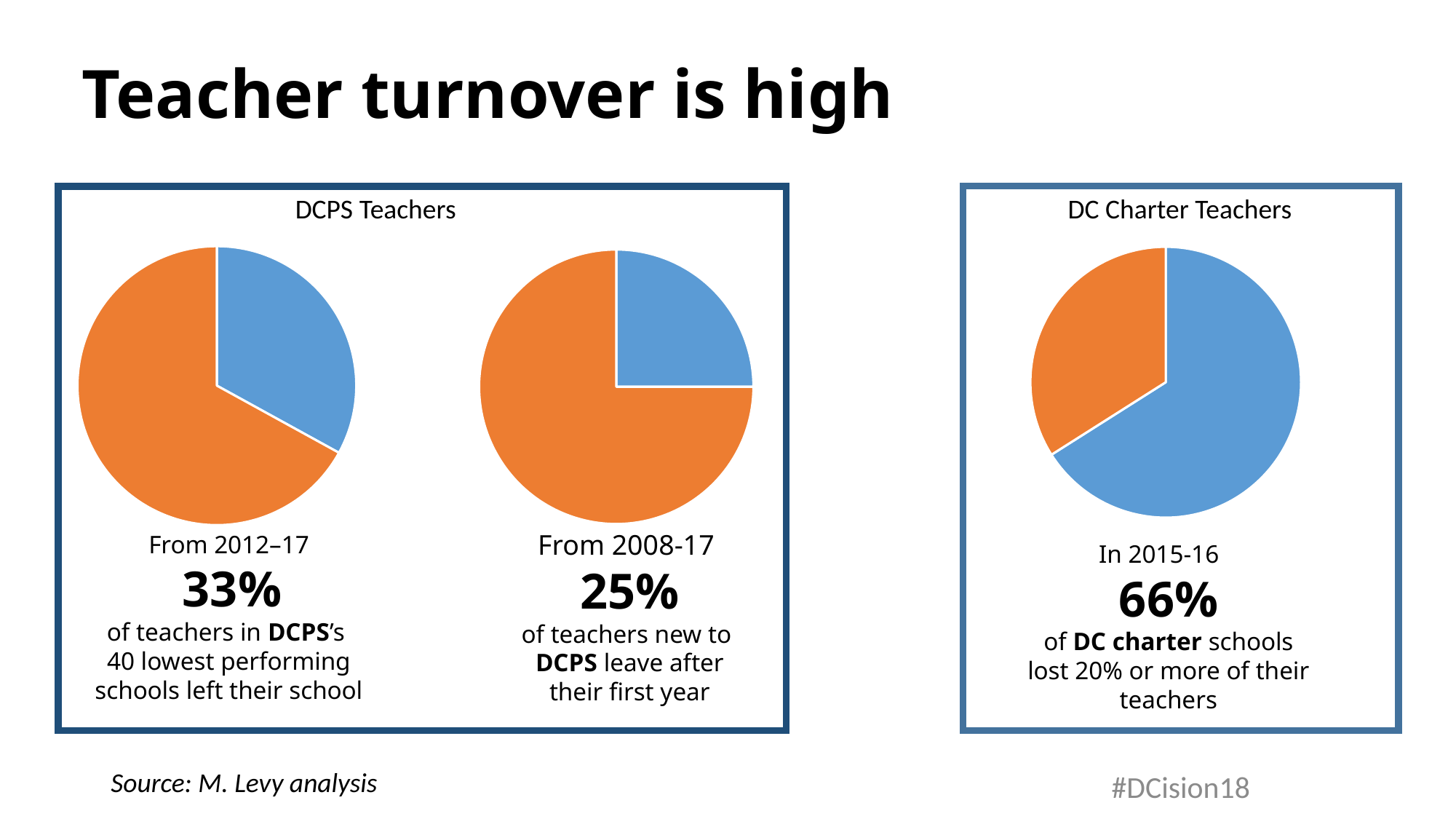
How many pie charts are shown on the slide? 3 Of the three pie charts on the slide, which one shows the highest percentage? DC Charter Teachers (66%) In the DCPS Teachers box, what is the difference between the 2012–17 percentage and the 2008-17 percentage? 8 percentage points In the DCPS Teachers box, what percentage of teachers new to DCPS leave after their first year (2008-17)? 25% In the DC Charter Teachers chart, what percentage of DC charter schools lost 20% or more of their teachers in 2015-16? 66% How many slices does each pie chart on the slide have? 2 What kind of chart is used on this slide? Pie chart In the left pie chart of the DCPS Teachers box (From 2012–17), what share of the pie does the blue slice represent? 33% In the DC Charter Teachers pie chart, what share of the pie does the blue slice represent? 66% What is the title of the box on the right side of the slide? DC Charter Teachers In the DCPS Teachers box, which is larger: the 2012–17 percentage or the 2008-17 percentage? The 2012–17 percentage (33%) In the DCPS Teachers box, what percentage of teachers in DCPS's 40 lowest performing schools left their school from 2012–17? 33%